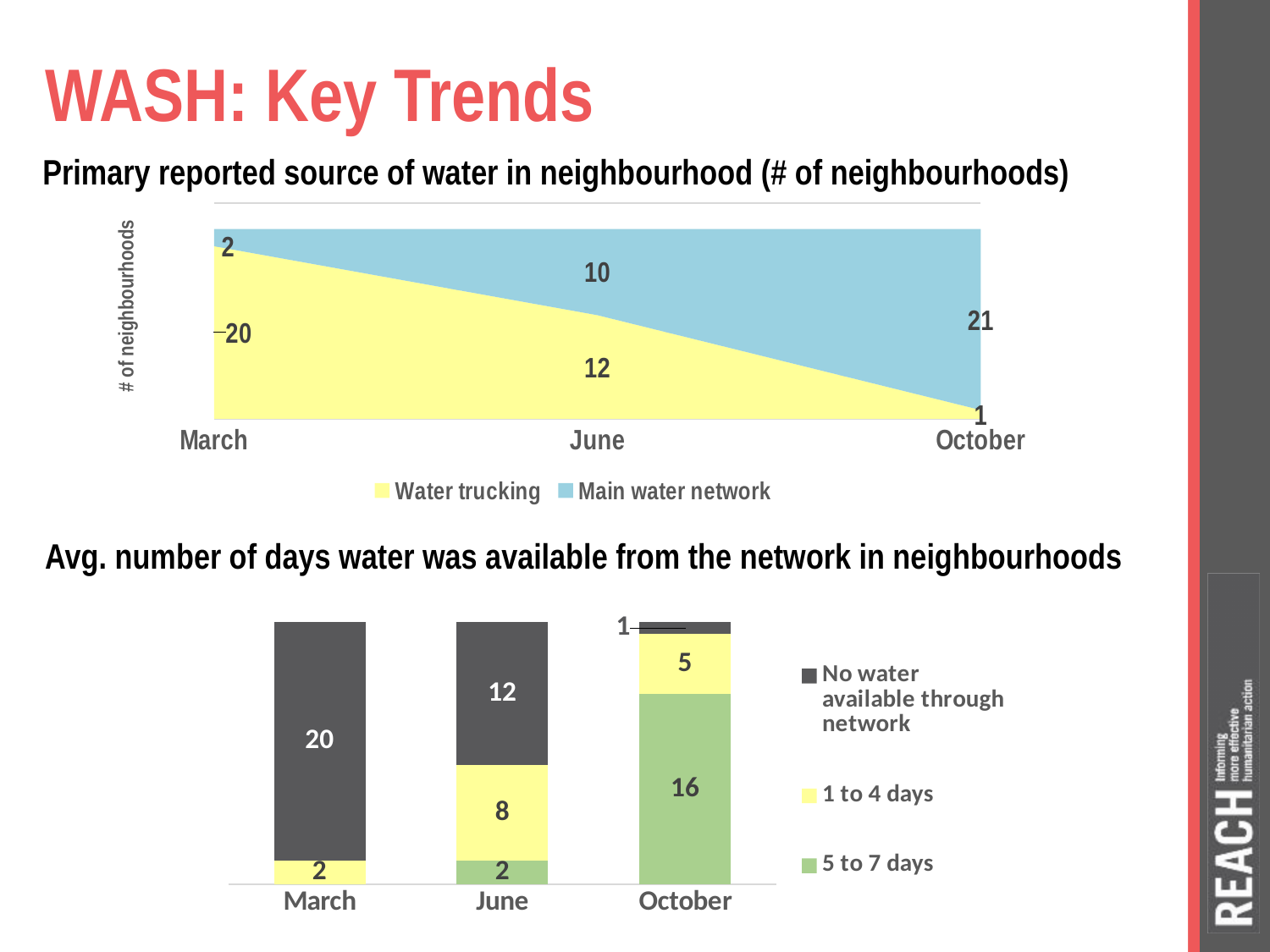
In the top chart (Primary reported source of water in neighbourhood), does the Water trucking value rise or fall from March to October? fall In the bottom chart (Avg. number of days water was available from the network), what is the value for 5 to 7 days in October? 16 In the top chart (Primary reported source of water in neighbourhood), what is the value for Main water network in October? 21 In the top chart (Primary reported source of water in neighbourhood), what is the difference between the Main water network values in October and March? 19 In the bottom chart (Avg. number of days water was available from the network), what is the value for No water available through network in June? 12 In the bottom chart (Avg. number of days water was available from the network), which month has the highest value for No water available through network? March What kind of chart is the bottom chart (Avg. number of days water was available from the network)? stacked bar chart In the top chart (Primary reported source of water in neighbourhood), what is the value for Main water network in June? 10 In the bottom chart (Avg. number of days water was available from the network), which is larger: the 1 to 4 days value in June or in October? June In the top chart (Primary reported source of water in neighbourhood), what is the value for Water trucking in March? 20 In the bottom chart (Avg. number of days water was available from the network), what is the total of the stacked bar for June? 22 In the top chart (Primary reported source of water in neighbourhood), how many series does the legend list? 2